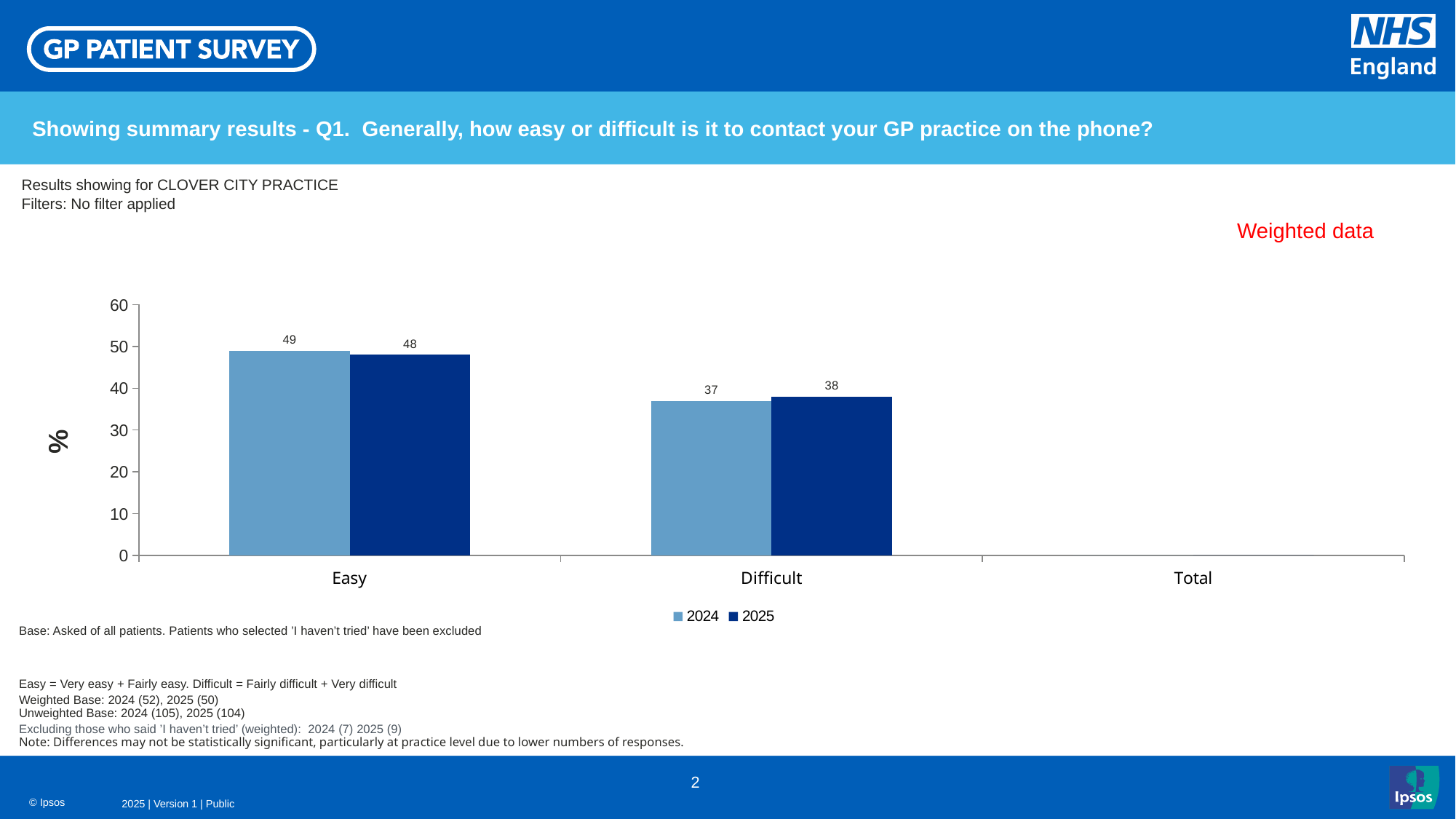
Is the 2025 value for Difficult greater or less than 40? less What is the value for Difficult in 2025? 38 What is the difference between the 2024 and 2025 values for Easy? 1 Which category has the highest value for 2025? Easy Which is larger: the 2024 value for Easy or the 2024 value for Difficult? Easy What label is shown on the vertical axis of the chart? % What is the value for Difficult in 2024? 37 How many series does the legend list? 2 What is the difference between the Easy and Difficult values in 2024? 12 What is the value for Easy in 2025? 48 What is the value for Easy in 2024? 49 What kind of chart is shown on the slide? Bar chart